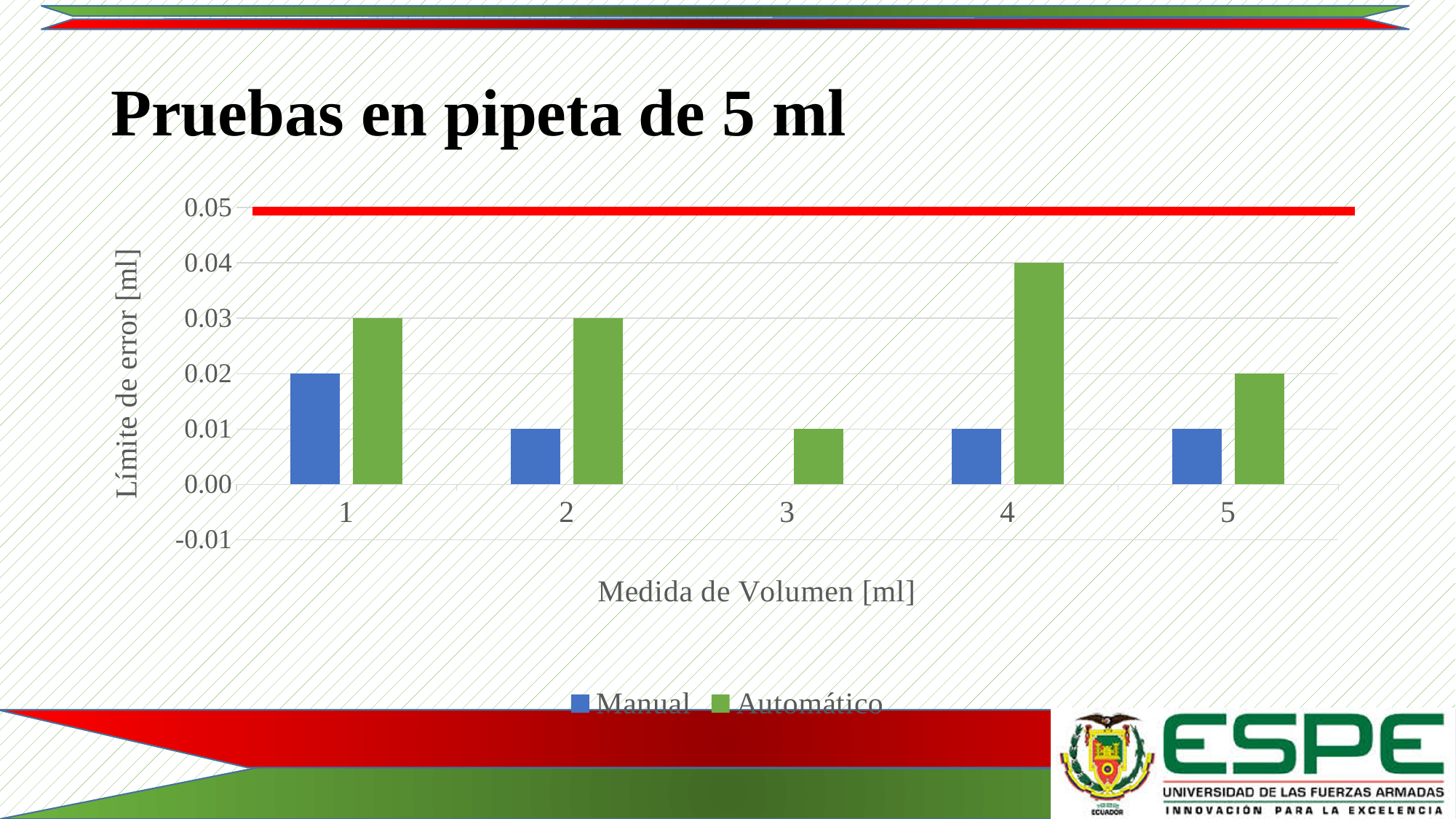
For which category is the Automático value highest? 4 What is the Manual value for category 1? 0.02 What is the label of the y axis? Límite de error [ml] How many series does the legend list? 2 What is the Automático value for category 3? 0.01 Which is larger for category 1, the Manual value or the Automático value? Automático What is the difference between the Automático and Manual values for category 4? 0.03 Is the Automático value for category 4 greater or less than 0.05? less What kind of chart is shown on the slide? bar chart For which category is the Automático value lowest? 3 How many volume measurement categories are shown on the x axis? 5 What is the Automático value for category 4? 0.04